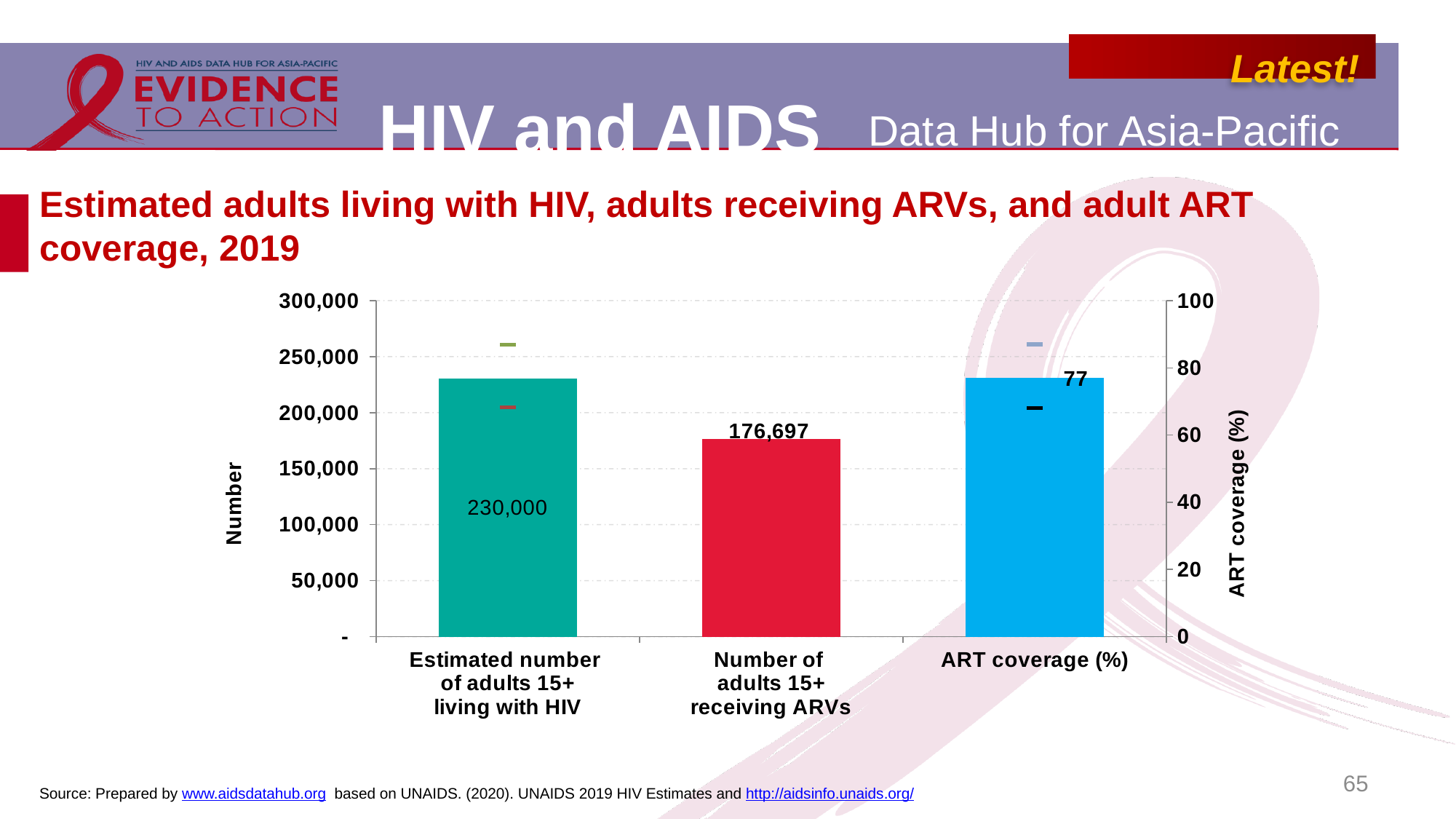
Is the ART coverage (%) value greater or less than 60 on the right axis? greater What is the ART coverage (%) value shown on the chart? 77 What is the number of adults 15+ receiving ARVs shown on the chart? 176,697 What is the title of the right-hand vertical axis? ART coverage (%) Is the value for the number of adults 15+ receiving ARVs greater or less than 200,000? less What is the estimated number of adults 15+ living with HIV shown on the chart? 230,000 Which is larger: the estimated number of adults 15+ living with HIV or the number of adults 15+ receiving ARVs? Estimated number of adults 15+ living with HIV What year does the chart title say the data refer to? 2019 How many bars are plotted on the chart? 3 What kind of chart is shown on the slide? Bar chart Of the two bars plotted against the left 'Number' axis, which category is the lowest? Number of adults 15+ receiving ARVs What is the difference between the estimated number of adults 15+ living with HIV and the number of adults 15+ receiving ARVs? 53,303